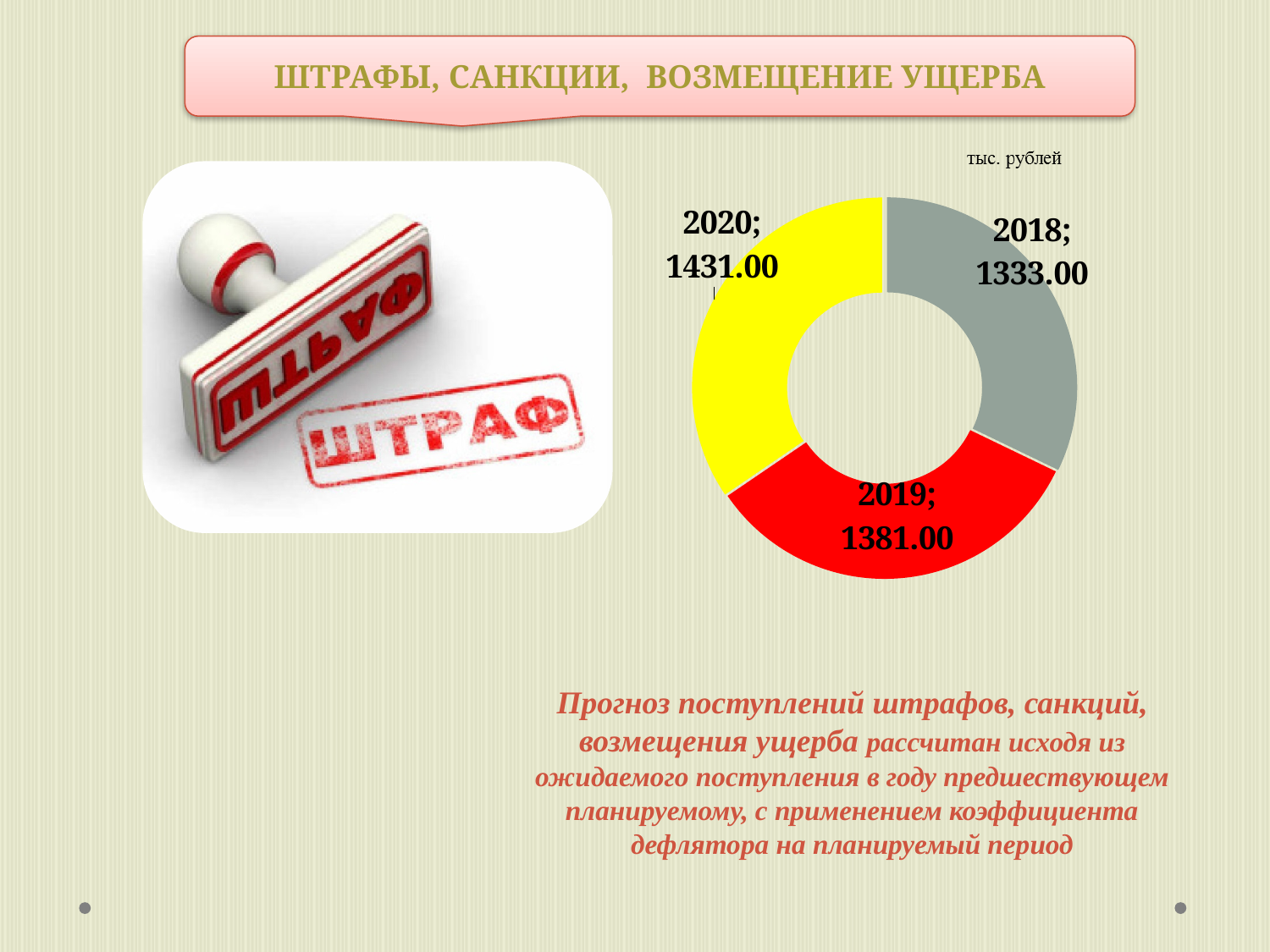
What is the difference between the values for 2019 and 2018? 48.00 What kind of chart is shown on the slide? Doughnut (pie) chart Which is larger, the value for 2019 or the value for 2020? 2020 What is the value for 2020 on the chart? 1431.00 What is the value for 2019 on the chart? 1381.00 What unit is indicated above the chart? тыс. рублей What is the difference between the values for 2020 and 2018? 98.00 Do the values rise or fall from 2018 to 2020? Rise How many slices does the chart have? 3 Which year has the highest value on the chart? 2020 Which year has the lowest value on the chart? 2018 What is the value for 2018 on the chart? 1333.00